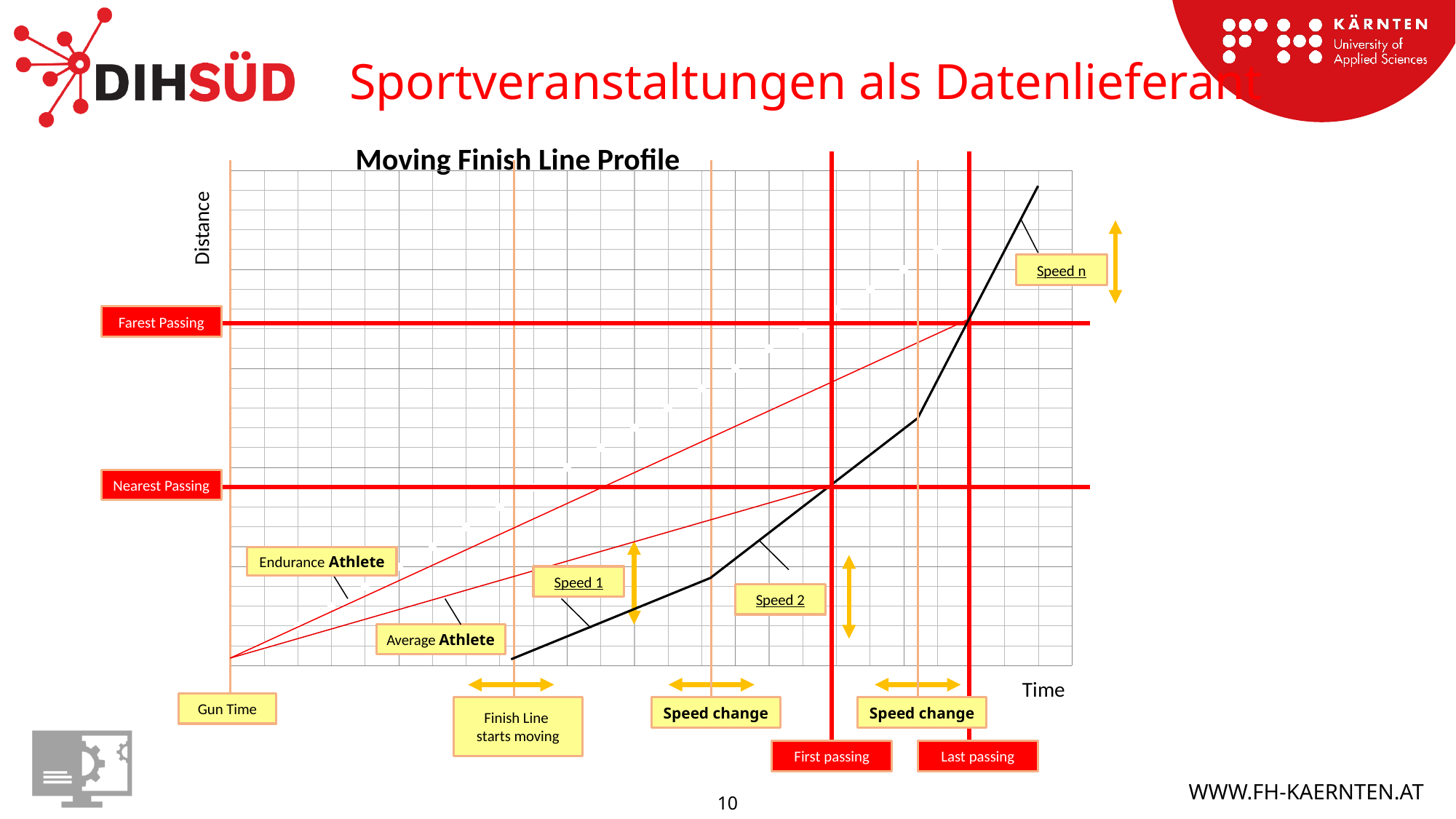
Which athlete line reaches a greater distance at the same time, Endurance Athlete or Average Athlete? Endurance Athlete Does the Endurance Athlete line rise or fall along the Time axis? rise Which vertical red line comes first along the Time axis, First passing or Last passing? First passing How many speed segments are labelled on the black finish line (Speed 1, Speed 2, Speed n)? 3 What kind of chart is the Moving Finish Line Profile? line chart What is the label of the vertical axis of the chart? Distance How many 'Speed change' annotations are shown below the Time axis? 2 What is the title of the chart? Moving Finish Line Profile Which horizontal passing line is at the greater distance, Farest Passing or Nearest Passing? Farest Passing What label is given to the point where the black line begins? Finish Line starts moving What label marks the point where the athlete lines start on the Time axis? Gun Time